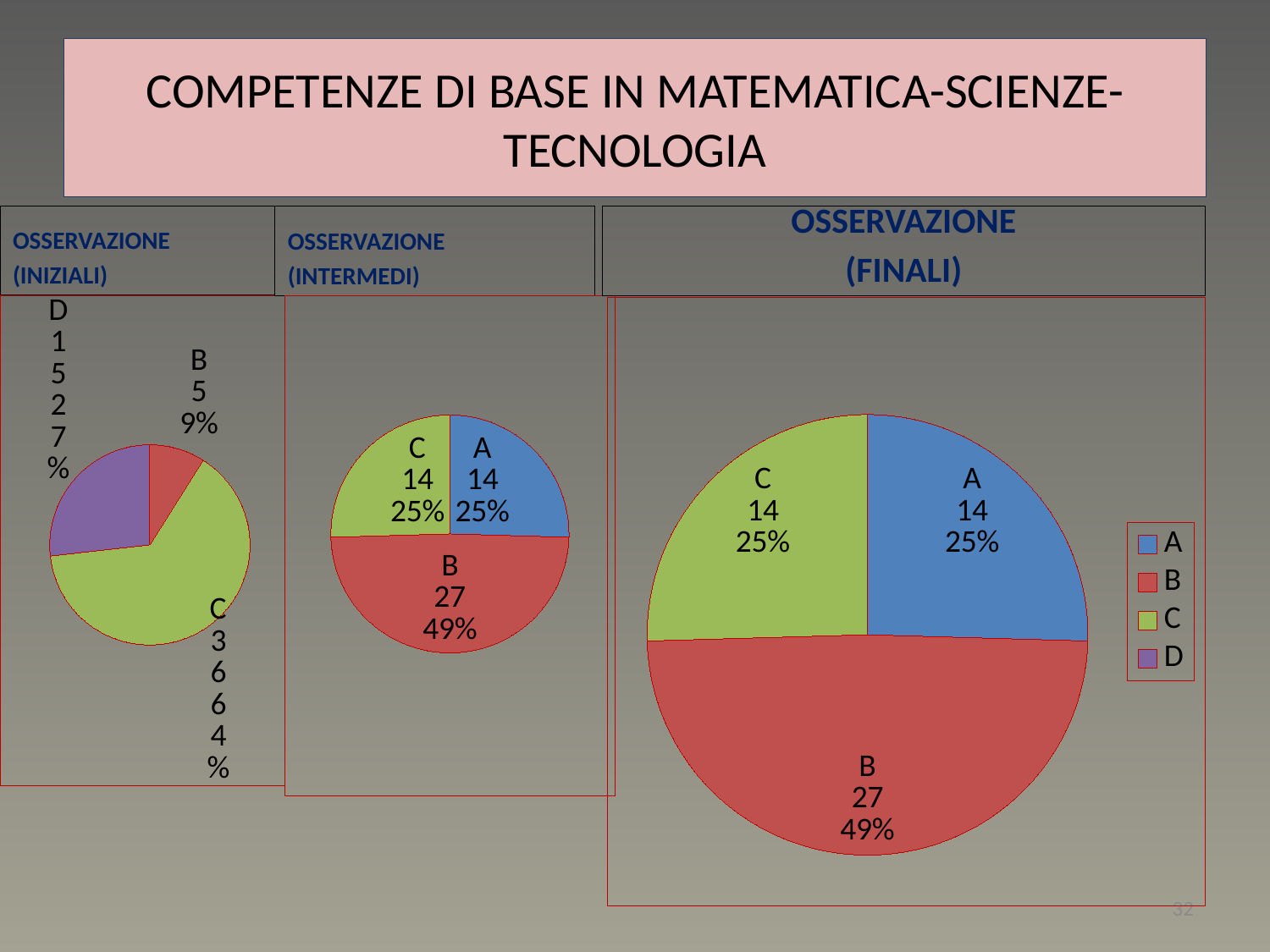
In the OSSERVAZIONE (INTERMEDI) chart, what value is shown for category C? 14 In the OSSERVAZIONE (INIZIALI) chart, what percentage is shown for category B? 9% What kind of chart is the OSSERVAZIONE (INTERMEDI) chart? Pie chart In the OSSERVAZIONE (FINALI) chart, which category has the largest slice? B How many entries does the legend of the OSSERVAZIONE (FINALI) chart list? 4 In the OSSERVAZIONE (INIZIALI) chart, which category has the smallest slice? B In the OSSERVAZIONE (INTERMEDI) chart, what is the difference between the values for B and A? 13 In the OSSERVAZIONE (INIZIALI) chart, which is larger, the value for D or the value for B? D In the OSSERVAZIONE (INIZIALI) chart, what value is shown for category C? 36 In the OSSERVAZIONE (INIZIALI) chart, which category has the largest slice? C In the OSSERVAZIONE (FINALI) chart, what percentage is shown for category A? 25% In the OSSERVAZIONE (FINALI) chart, what value is shown for category B? 27